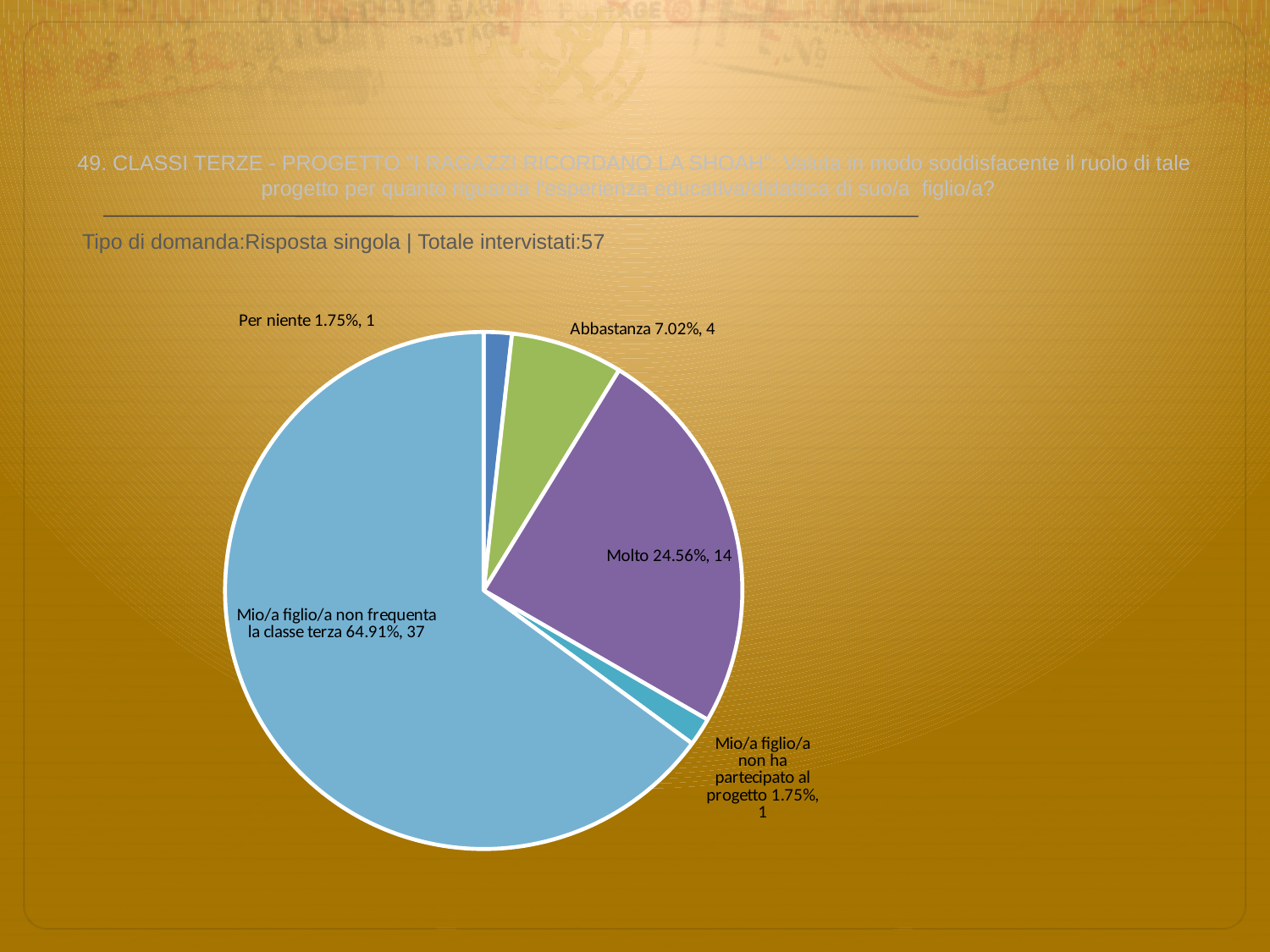
What kind of chart is shown on the slide? Pie chart How many respondents answered "Abbastanza"? 4 How many respondents answered "Mio/a figlio/a non frequenta la classe terza"? 37 What percentage share does the "Mio/a figlio/a non ha partecipato al progetto" slice have? 1.75% What is the difference between the number of respondents for "Mio/a figlio/a non frequenta la classe terza" and for "Molto"? 23 What is the total number of respondents stated on the slide? 57 Which category has the largest slice of the pie? Mio/a figlio/a non frequenta la classe terza What percentage share does the "Per niente" slice have? 1.75% What is the difference between the number of respondents for "Molto" and for "Abbastanza"? 10 What percentage share does the "Molto" slice have? 24.56% How many slices does the pie chart have? 5 Which is larger, the count for "Molto" or the count for "Abbastanza"? Molto